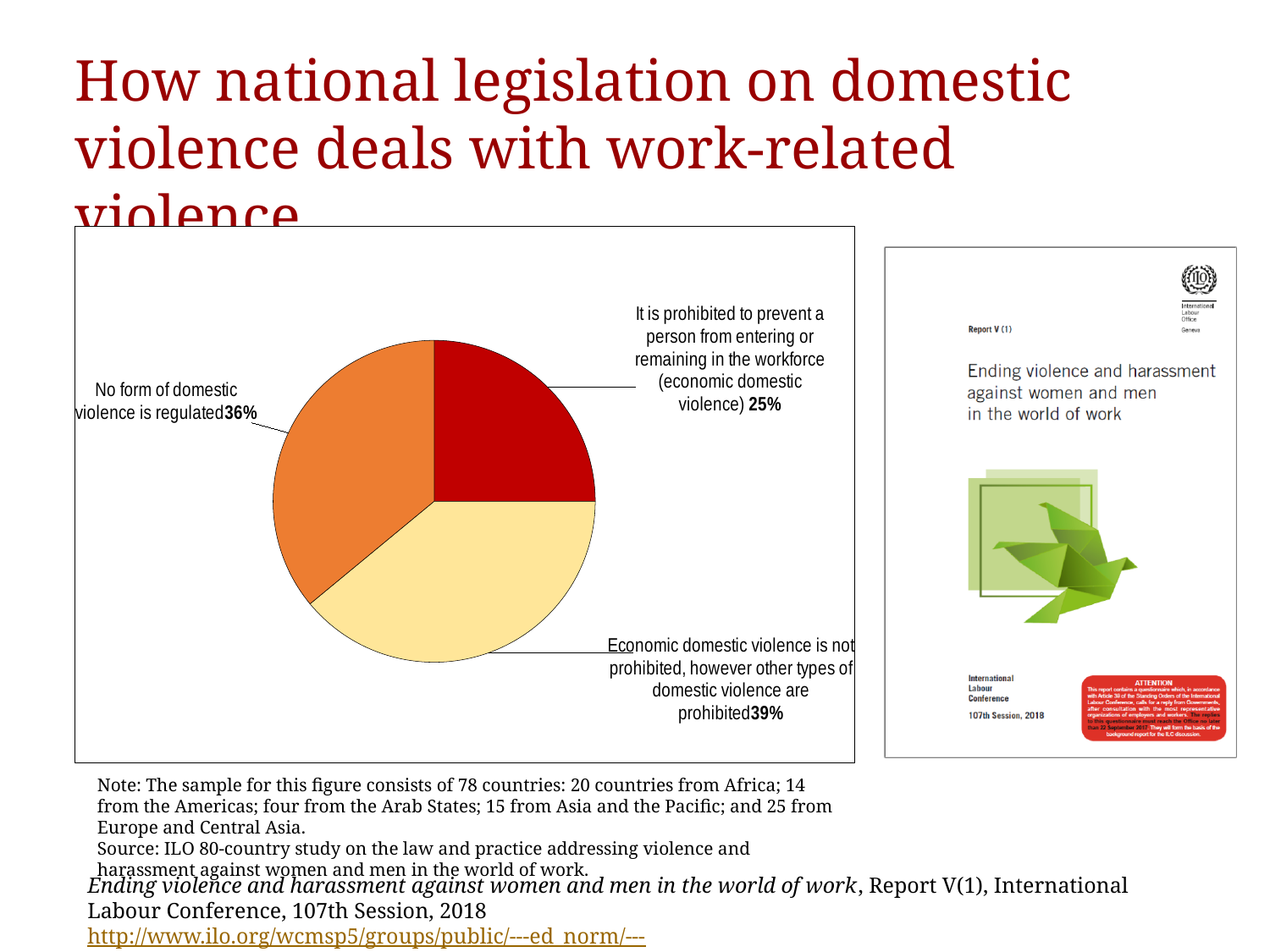
According to the note below the chart, how many countries make up the sample for this figure? 78 What percentage is shown for "Economic domestic violence is not prohibited, however other types of domestic violence are prohibited"? 39% How many slices does the pie chart have? 3 Which slice of the pie chart is the largest? Economic domestic violence is not prohibited, however other types of domestic violence are prohibited Which slice of the pie chart is the smallest? It is prohibited to prevent a person from entering or remaining in the workforce (economic domestic violence) Which is larger: the share for "No form of domestic violence is regulated" or the share for "Economic domestic violence is not prohibited, however other types of domestic violence are prohibited"? Economic domestic violence is not prohibited, however other types of domestic violence are prohibited What is the difference in percentage points between the "No form of domestic violence is regulated" slice and the "economic domestic violence" prohibited slice? 11 What is the combined percentage of the 25% and 39% slices? 64% What colour is the slice representing 25%? red What share of the pie is labelled "No form of domestic violence is regulated"? 36% What kind of chart is shown on the slide? pie chart What percentage is shown for "It is prohibited to prevent a person from entering or remaining in the workforce (economic domestic violence)"? 25%